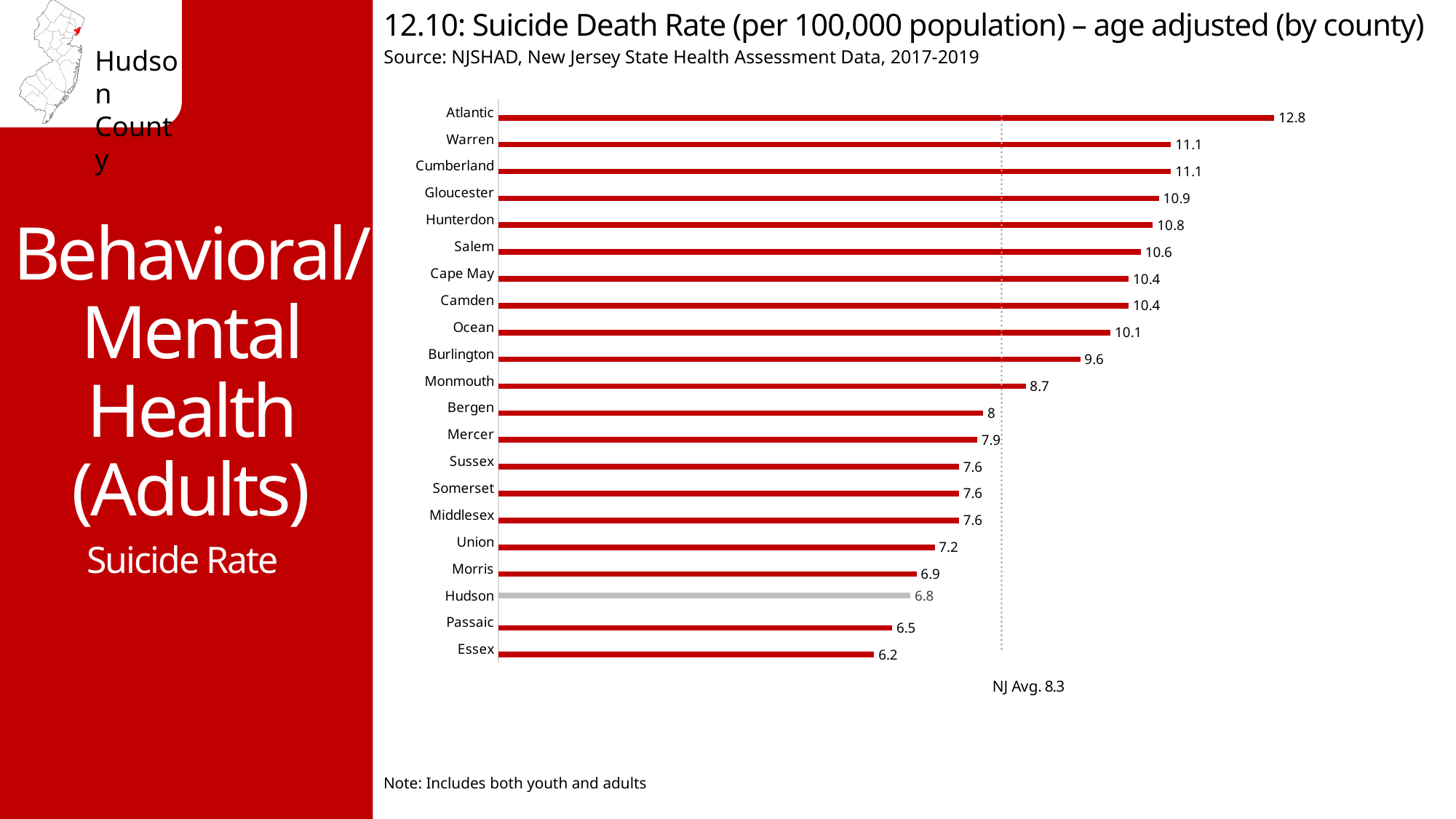
What is the suicide death rate for Hudson County? 6.8 What is the NJ average suicide death rate marked by the dotted line? 8.3 What is the suicide death rate for Monmouth County? 8.7 Which has a higher suicide death rate, Hudson or Morris? Morris How many counties are shown in the chart? 21 What kind of chart is shown on the slide? Bar chart What is the difference between the suicide death rates of Atlantic and Essex counties? 6.6 Which has a higher suicide death rate, Gloucester or Ocean? Gloucester Which county has the highest suicide death rate? Atlantic What is the suicide death rate for Atlantic County? 12.8 Which county has the lowest suicide death rate? Essex What is the difference between the suicide death rates of Hudson and Passaic counties? 0.3